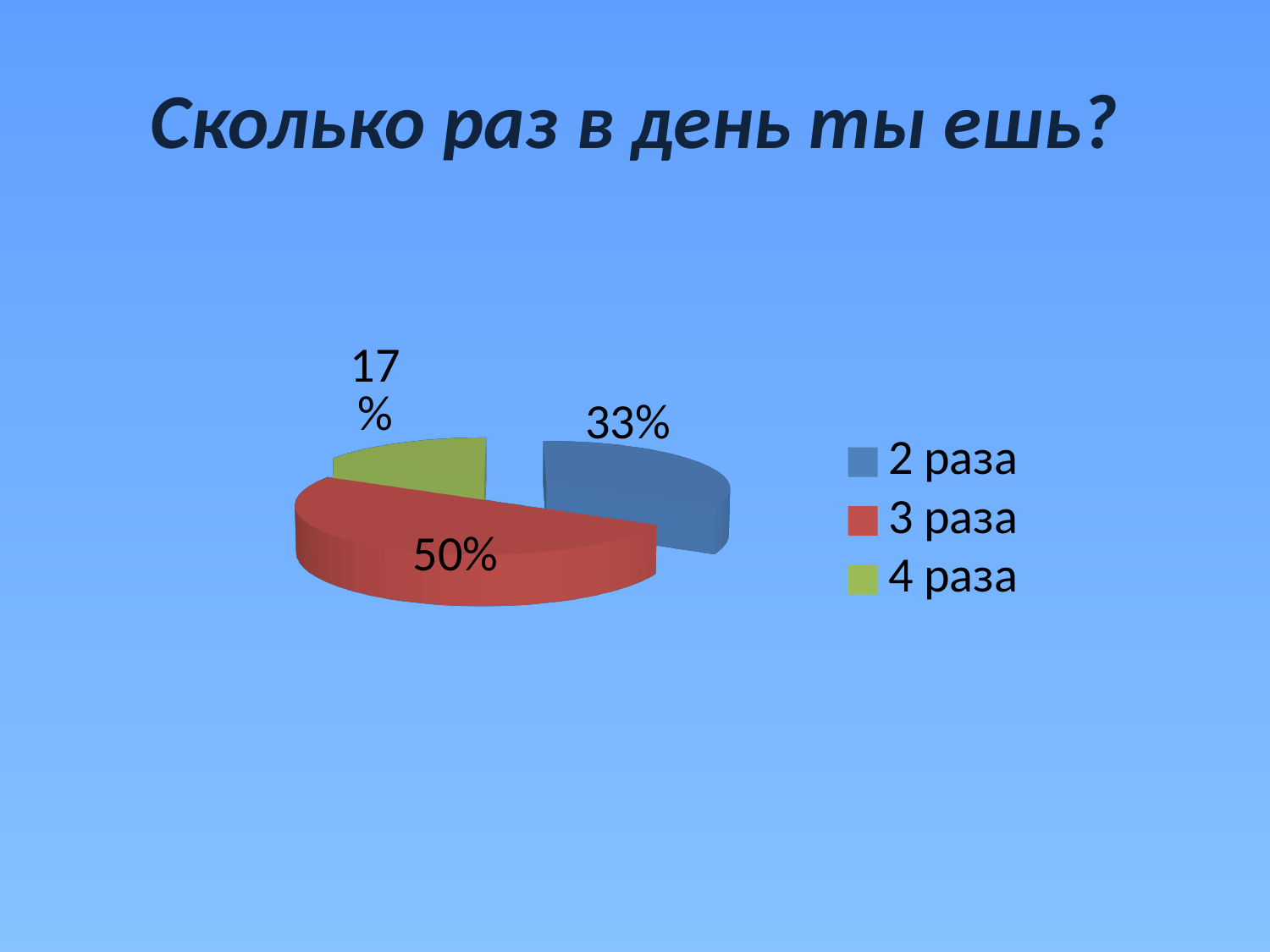
Which category has the largest share of the pie? 3 раза What kind of chart is shown on the slide? pie chart What percentage of respondents eat 2 раза a day? 33% What is the title of the chart? Сколько раз в день ты ешь? Which is larger, the share for 2 раза or the share for 4 раза? 2 раза How many categories does the pie chart show? 3 What is the difference in percentage points between the 2 раза and 4 раза slices? 16 Which category has the smallest share of the pie? 4 раза What percentage of respondents eat 3 раза a day? 50% What is the difference in percentage points between the 3 раза and 2 раза slices? 17 What percentage of respondents eat 4 раза a day? 17% What colour is the slice for 3 раза? red